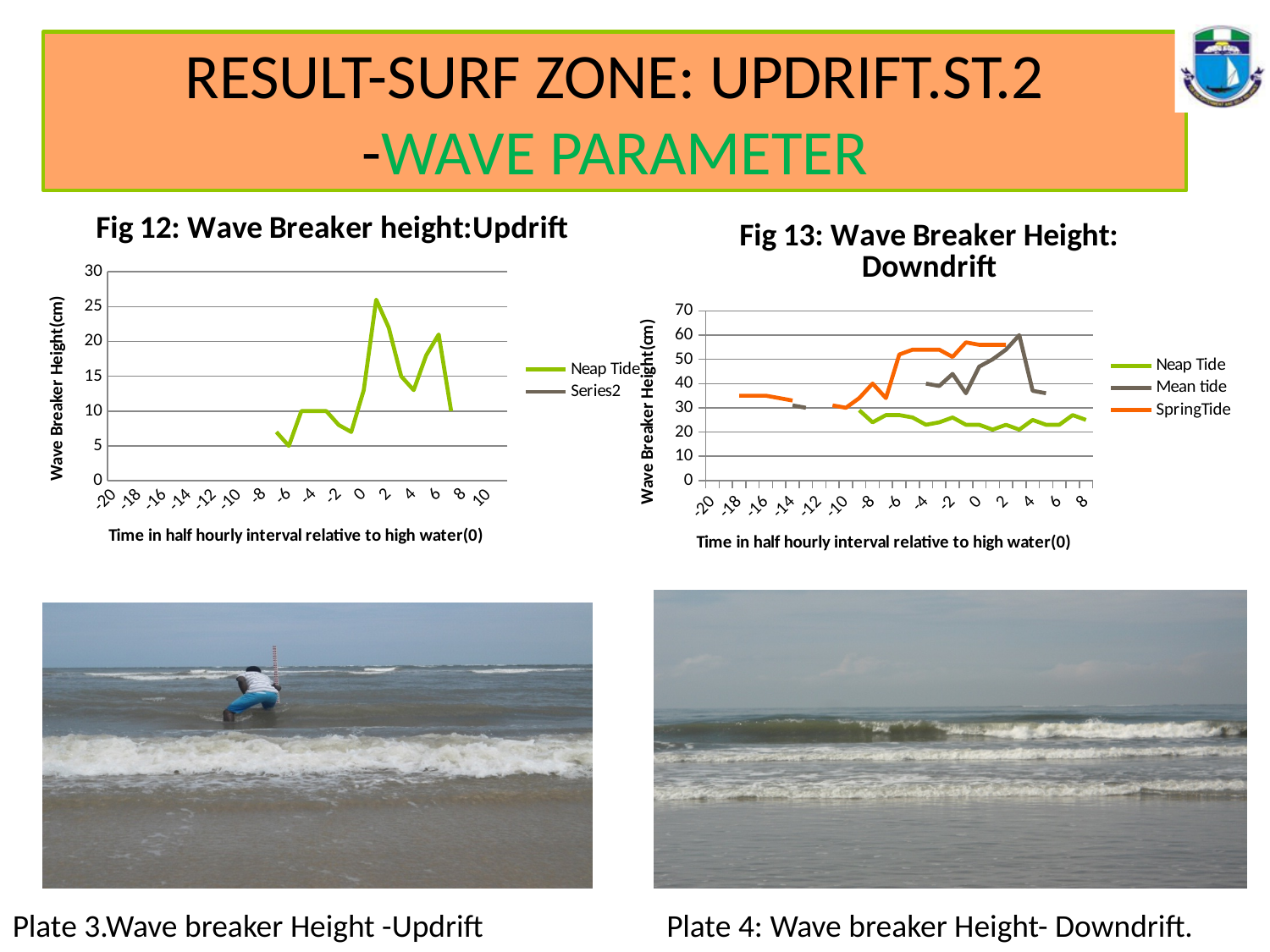
In Fig 13: Wave Breaker Height: Downdrift, is the Neap Tide value at time 0 greater or less than 30? less How many series does the legend of Fig 13: Wave Breaker Height: Downdrift list? 3 What is the y-axis title of Fig 13: Wave Breaker Height: Downdrift? Wave Breaker Height(cm) In Fig 12: Wave Breaker height:Updrift, is the Neap Tide value at time -6 greater or less than 10? less How many series does the legend of Fig 12: Wave Breaker height:Updrift list? 2 In Fig 12: Wave Breaker height:Updrift, is the peak value of the Neap Tide line greater or less than 20? greater In Fig 13: Wave Breaker Height: Downdrift, at time -8, which is larger: SpringTide or Neap Tide? SpringTide What kind of chart is Fig 12: Wave Breaker height:Updrift? line chart In Fig 13: Wave Breaker Height: Downdrift, which series has the lowest values overall? Neap Tide What is the x-axis title of Fig 12: Wave Breaker height:Updrift? Time in half hourly interval relative to high water(0)